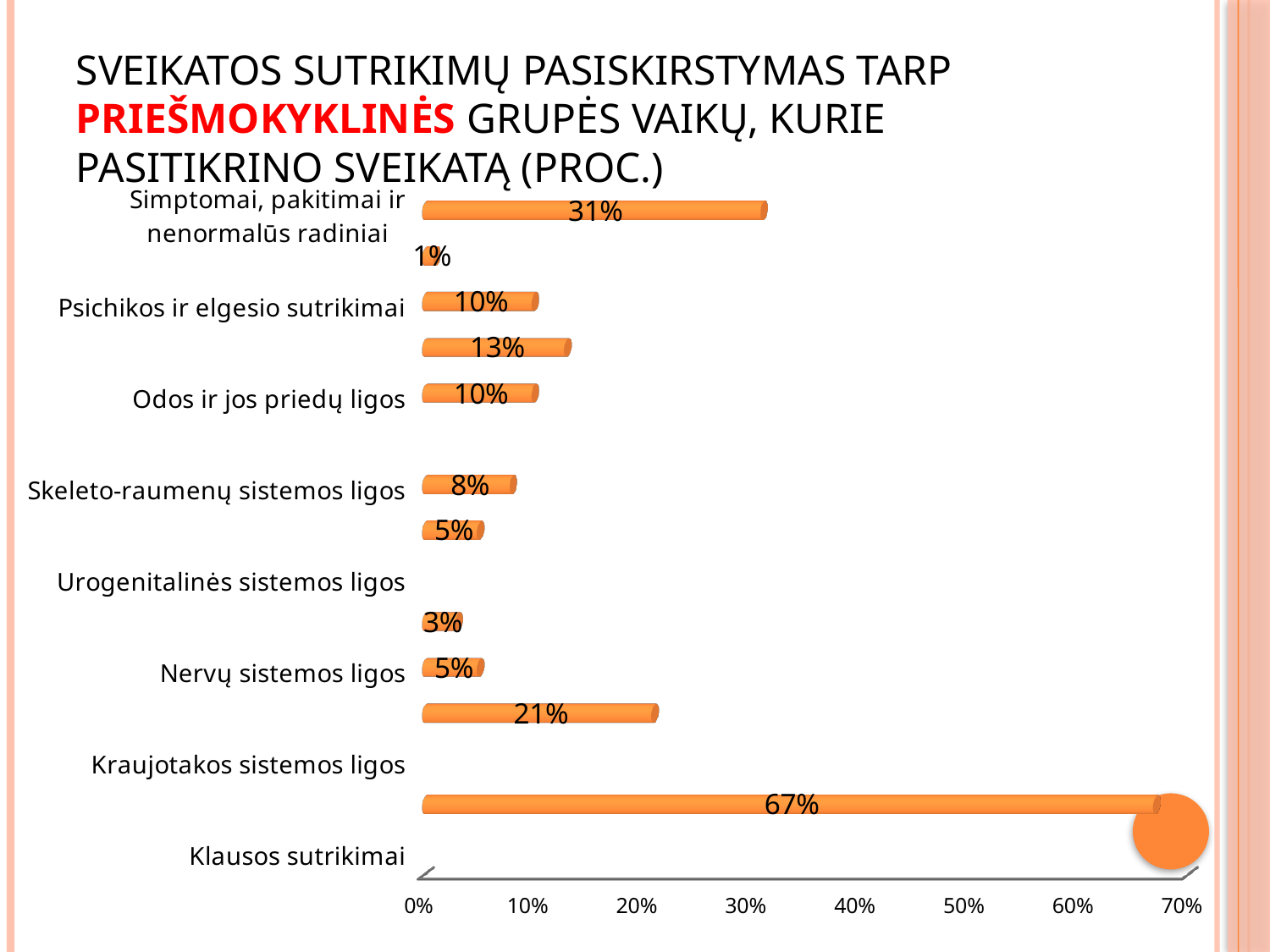
What type of chart is shown on the slide? Bar chart What is the difference between the values for "Simptomai, pakitimai ir nenormalūs radiniai" and "Psichikos ir elgesio sutrikimai"? 21 percentage points What is the value for "Simptomai, pakitimai ir nenormalūs radiniai"? 31% What is the value for "Nervų sistemos ligos"? 5% What is the value for "Psichikos ir elgesio sutrikimai"? 10% What is the smallest value shown on the chart? 1% What is the value for "Odos ir jos priedų ligos"? 10% What is the value for "Skeleto-raumenų sistemos ligos"? 8% Is the longest bar's value greater or less than 60%? greater What is the largest value shown on the chart? 67% What is the highest value shown on the horizontal axis? 70% Which is larger, the value for "Skeleto-raumenų sistemos ligos" or for "Nervų sistemos ligos"? Skeleto-raumenų sistemos ligos